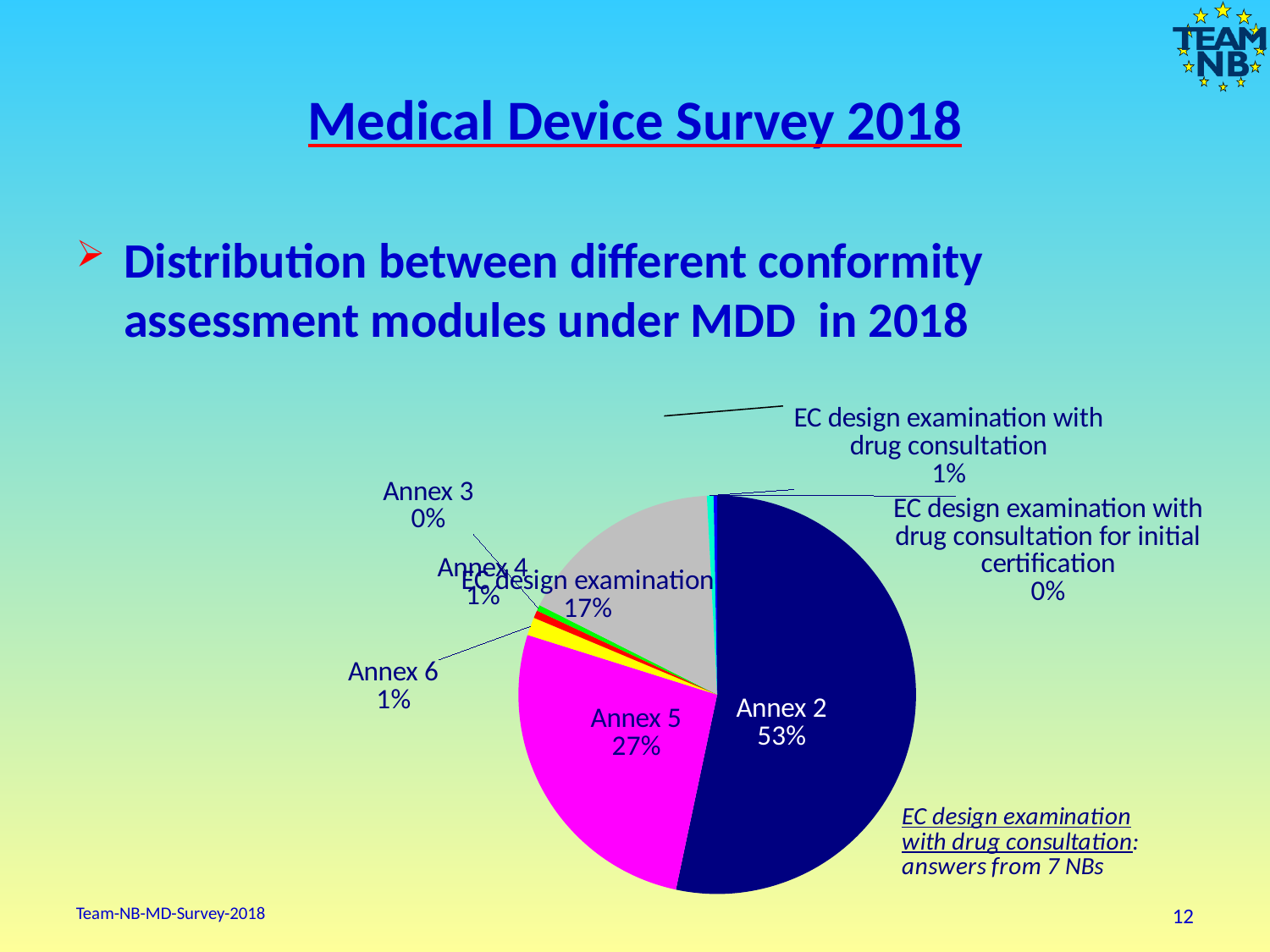
What percentage is shown for EC design examination with drug consultation? 1% What colour is the Annex 5 slice of the pie? magenta Which category has the largest slice of the pie? Annex 2 What share of the pie does Annex 5 represent? 27% What kind of chart is shown on the slide? pie chart How many slices (categories) are labelled on the pie chart? 8 What percentage is shown for EC design examination? 17% What share of the pie does Annex 2 represent? 53% Which is larger, the share for Annex 5 or the share for EC design examination? Annex 5 What percentage is shown for Annex 6? 1% What percentage is shown for Annex 3? 0% What is the difference in percentage points between Annex 2 and Annex 5? 26